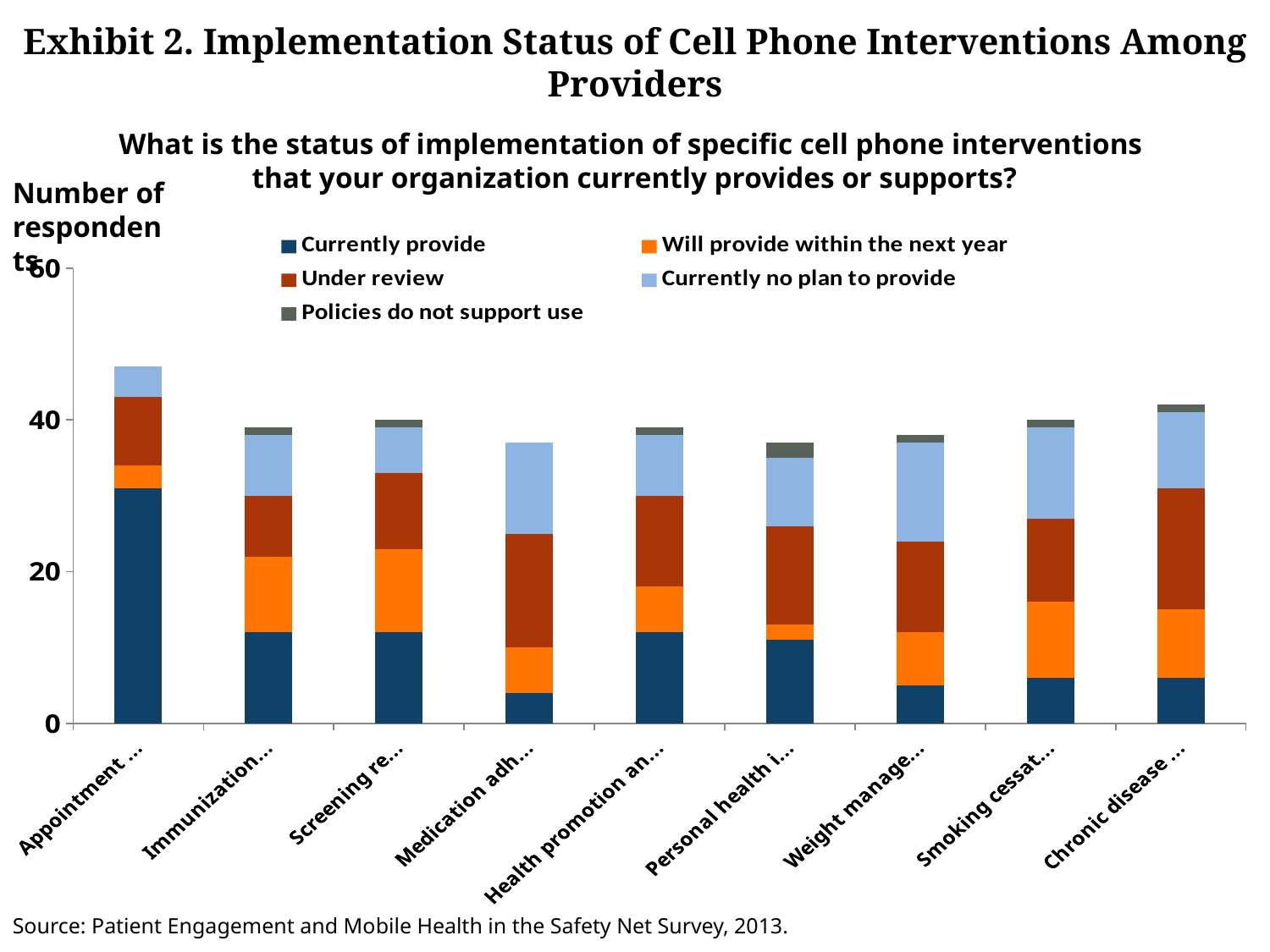
Is the total height of the bar for "Appointment ..." greater or less than 40? greater Is the "Currently provide" value for "Appointment ..." greater or less than 20? greater Which legend entry is shown in dark blue? Currently provide What kind of chart is shown on the slide? stacked bar chart Which has a larger "Currently provide" value: "Appointment ..." or "Immunization..."? Appointment ... How many intervention categories are plotted along the x axis? 9 What is the label on the vertical axis? Number of respondents Which has a larger "Currently no plan to provide" segment: "Medication adh..." or "Appointment ..."? Medication adh... Is the "Currently provide" value for "Medication adh..." greater or less than 20? less How many series does the legend list? 5 Which category has the tallest stacked bar overall? Appointment ...